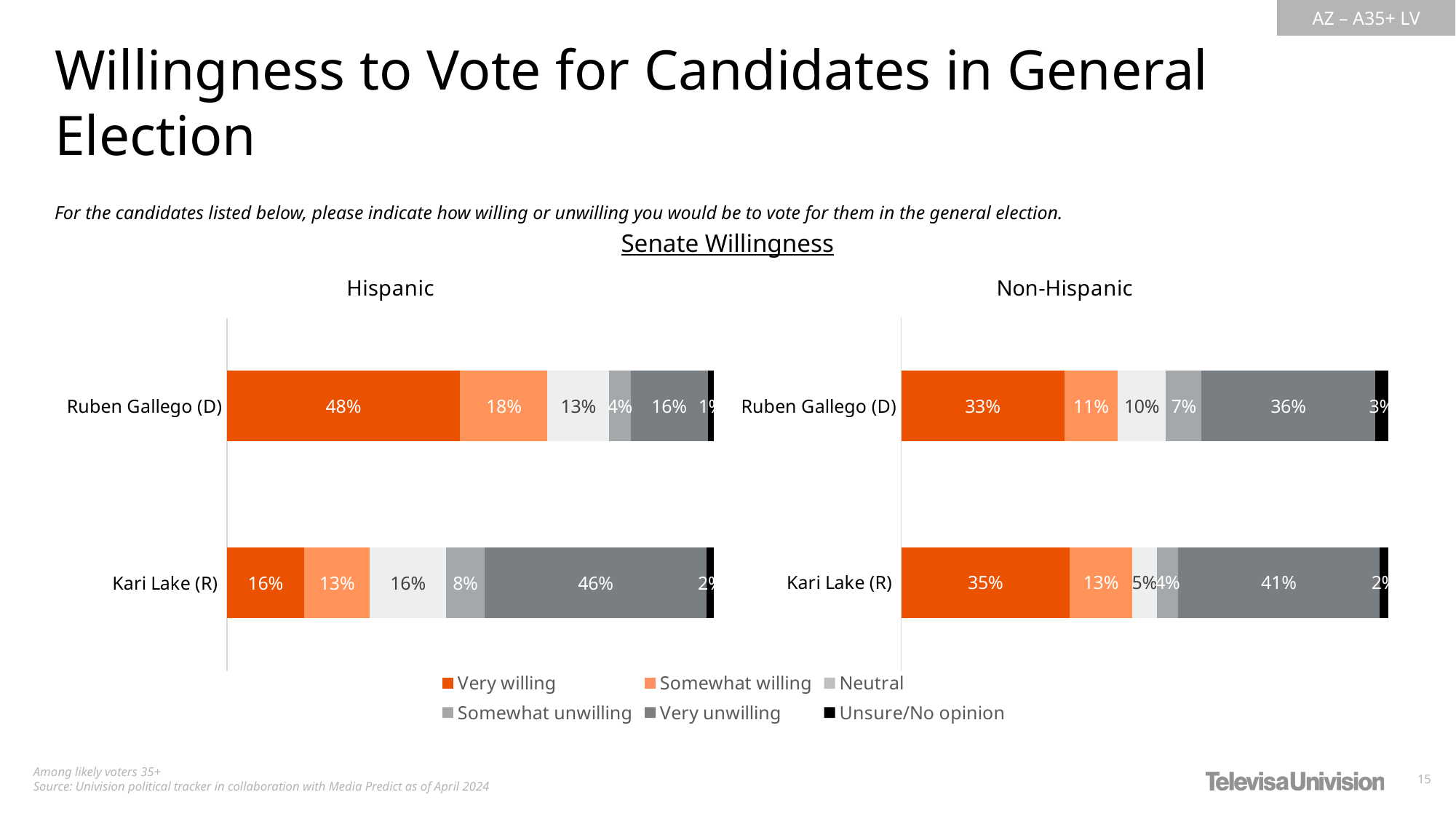
In the Non-Hispanic chart, what percentage of respondents are neutral about voting for Ruben Gallego (D)? 10% In the Hispanic chart, what percentage of respondents are very unwilling to vote for Kari Lake (R)? 46% How many candidates are shown in the Hispanic chart? 2 In the Non-Hispanic chart, which candidate has the higher very willing percentage? Kari Lake (R) What type of chart is used to show Senate Willingness? Stacked bar chart In the Hispanic chart, which candidate has the higher very willing percentage? Ruben Gallego (D) In the Hispanic chart, what is the combined very willing and somewhat willing percentage for Ruben Gallego (D)? 66% In the Hispanic chart, what percentage of respondents are very willing to vote for Ruben Gallego (D)? 48% In the Hispanic chart, what is the difference between the very willing percentages for Ruben Gallego (D) and Kari Lake (R)? 32% In the Non-Hispanic chart, what percentage of respondents are very unwilling to vote for Kari Lake (R)? 41% How many series does the legend list for the charts? 6 In the Non-Hispanic chart, what is the difference between the very unwilling percentages for Kari Lake (R) and Ruben Gallego (D)? 5%